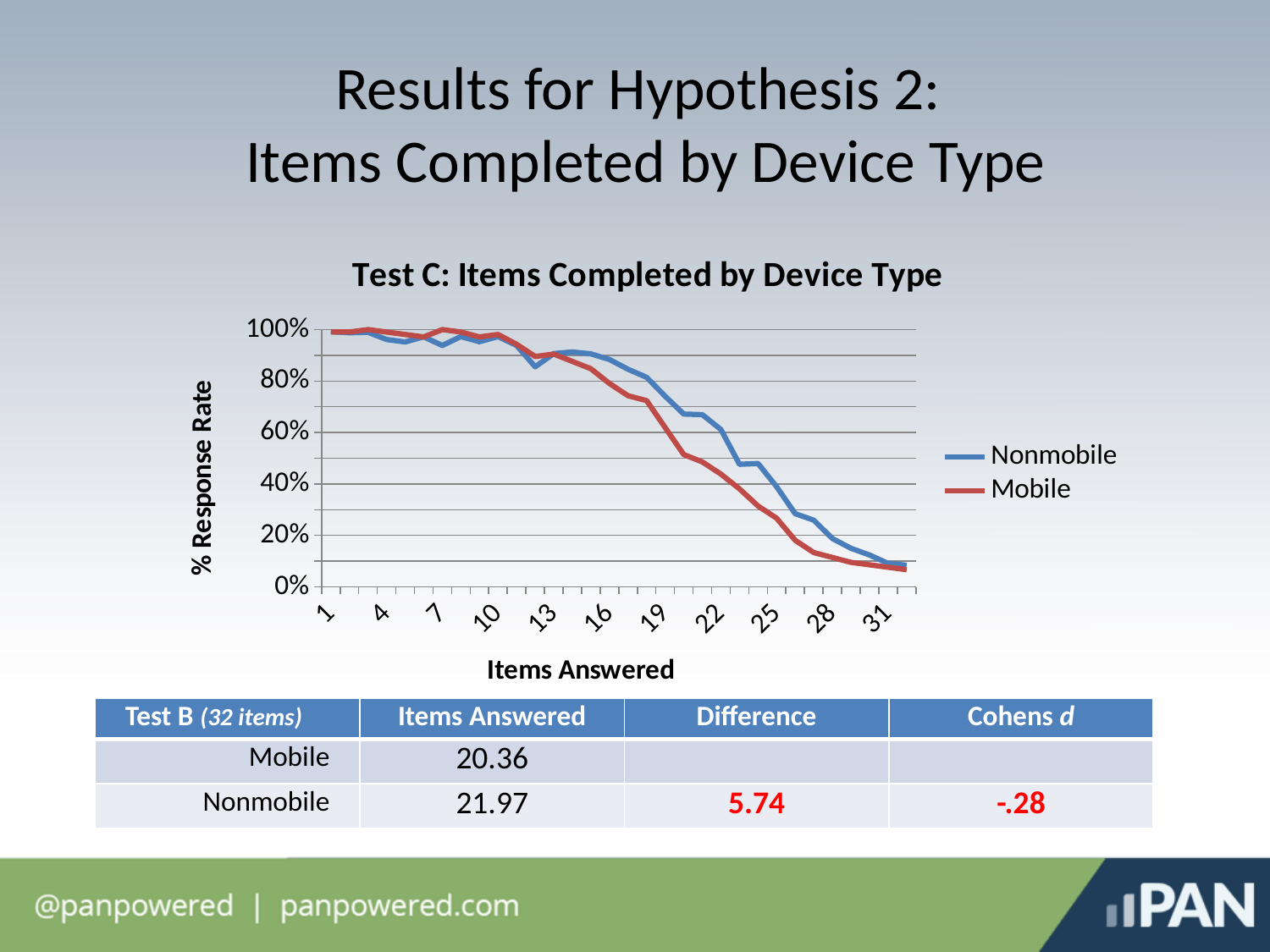
How many labeled tick marks are shown on the Items Answered axis? 11 How many series does the chart legend list? 2 Do the response rates rise or fall as the number of items answered increases? Fall Is the Mobile response rate at item 28 greater or less than 20%? less What is the title of the chart? Test C: Items Completed by Device Type What is the label on the vertical axis of the chart? % Response Rate What kind of chart is shown on the slide? Line chart At item 19, which series has the higher response rate, Nonmobile or Mobile? Nonmobile At item 22, which series has the higher response rate, Nonmobile or Mobile? Nonmobile Is the Mobile response rate at item 1 greater or less than 80%? greater Is the Nonmobile response rate at item 19 greater or less than 60%? greater